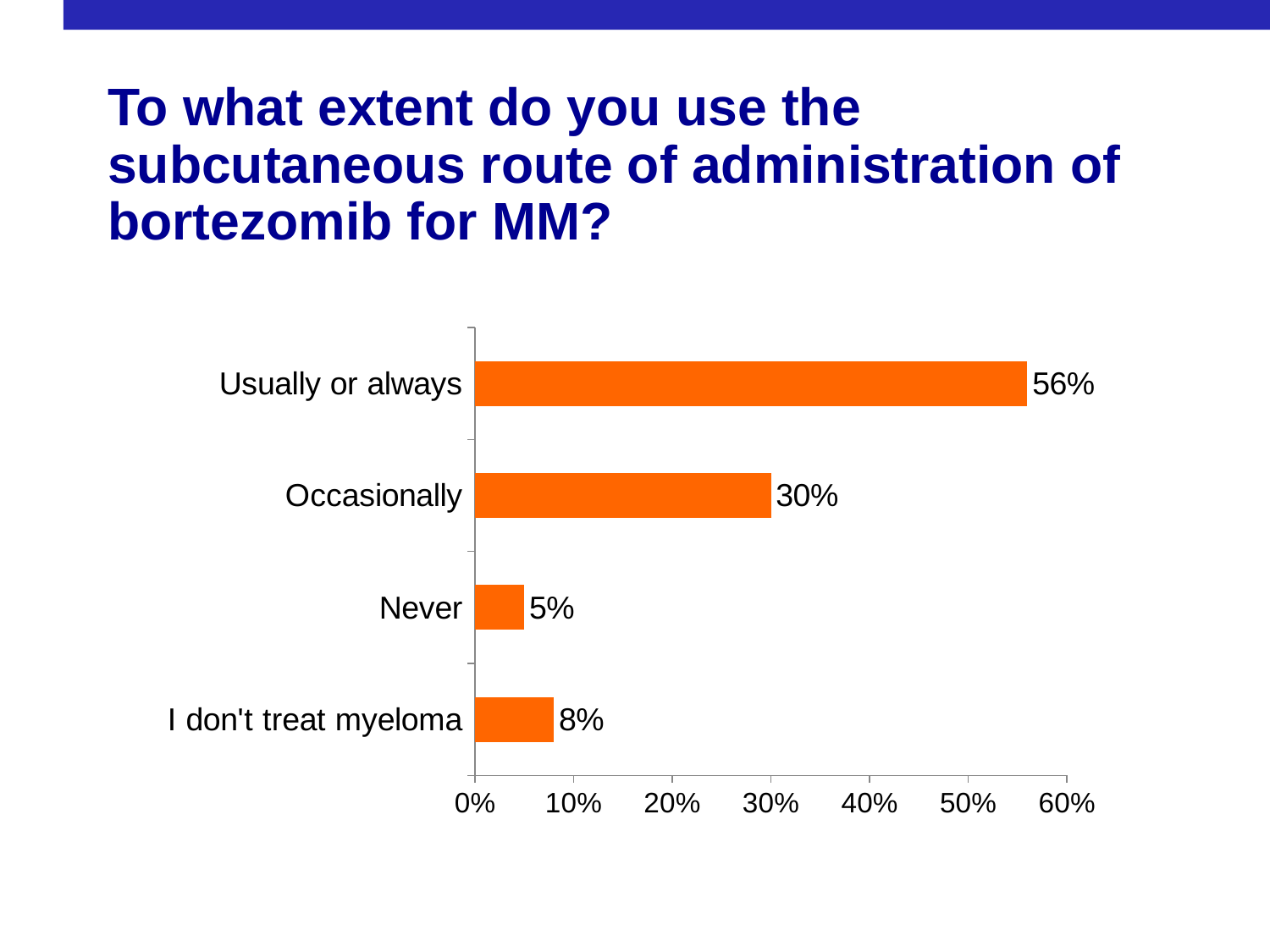
What is the value for 'Never'? 5% What is the value for 'I don't treat myeloma'? 8% How many categories are shown in the chart? 4 What is the value for 'Occasionally'? 30% Which category has the highest value? Usually or always What percentage of respondents answered 'Usually or always'? 56% Which category has the lowest value? Never What kind of chart is shown on the slide? Bar chart What is the highest value shown on the x axis? 60% Which is larger, 'Never' or 'I don't treat myeloma'? I don't treat myeloma What is the difference between 'Usually or always' and 'Occasionally'? 26% Is the value for 'Occasionally' greater or less than 40%? less